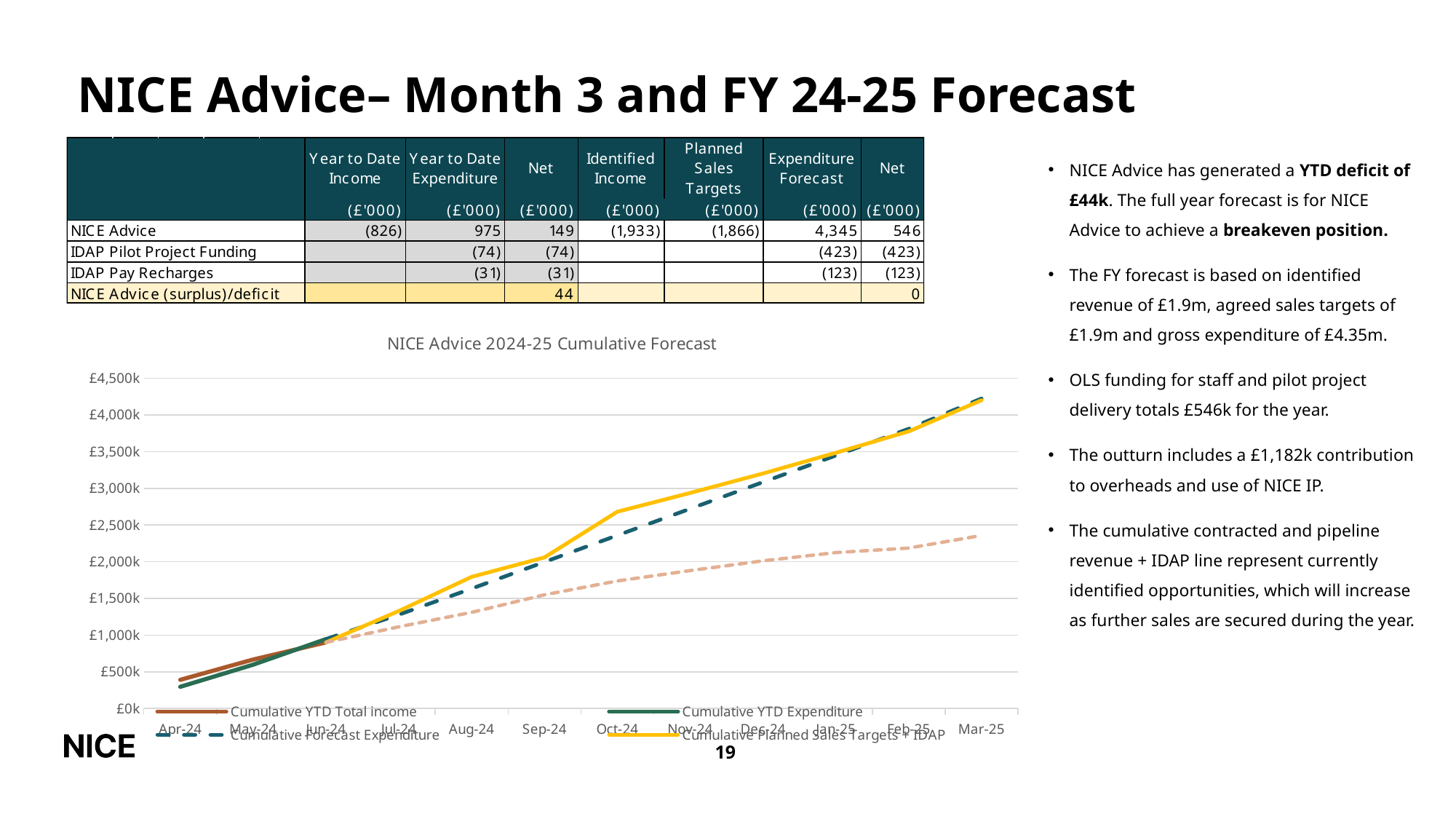
Is the value of Cumulative YTD Expenditure at Jun-24 greater or less than £1,000k? less How many series does the legend of the chart list? 4 Is the value of Cumulative Forecast Expenditure at Mar-25 greater or less than £4,000k? greater Is the value of Cumulative Planned Sales Targets + IDAP at Oct-24 greater or less than £2,500k? greater What kind of chart is the NICE Advice 2024-25 Cumulative Forecast chart? line chart Which month is the first category on the x axis of the chart? Apr-24 Is the value of Cumulative Forecast Expenditure larger at Mar-25 or at Jul-24? Mar-25 How many months are shown along the x axis of the chart? 12 What is the title of the chart on the slide? NICE Advice 2024-25 Cumulative Forecast Does the Cumulative Planned Sales Targets + IDAP line rise or fall from Apr-24 to Mar-25? rise